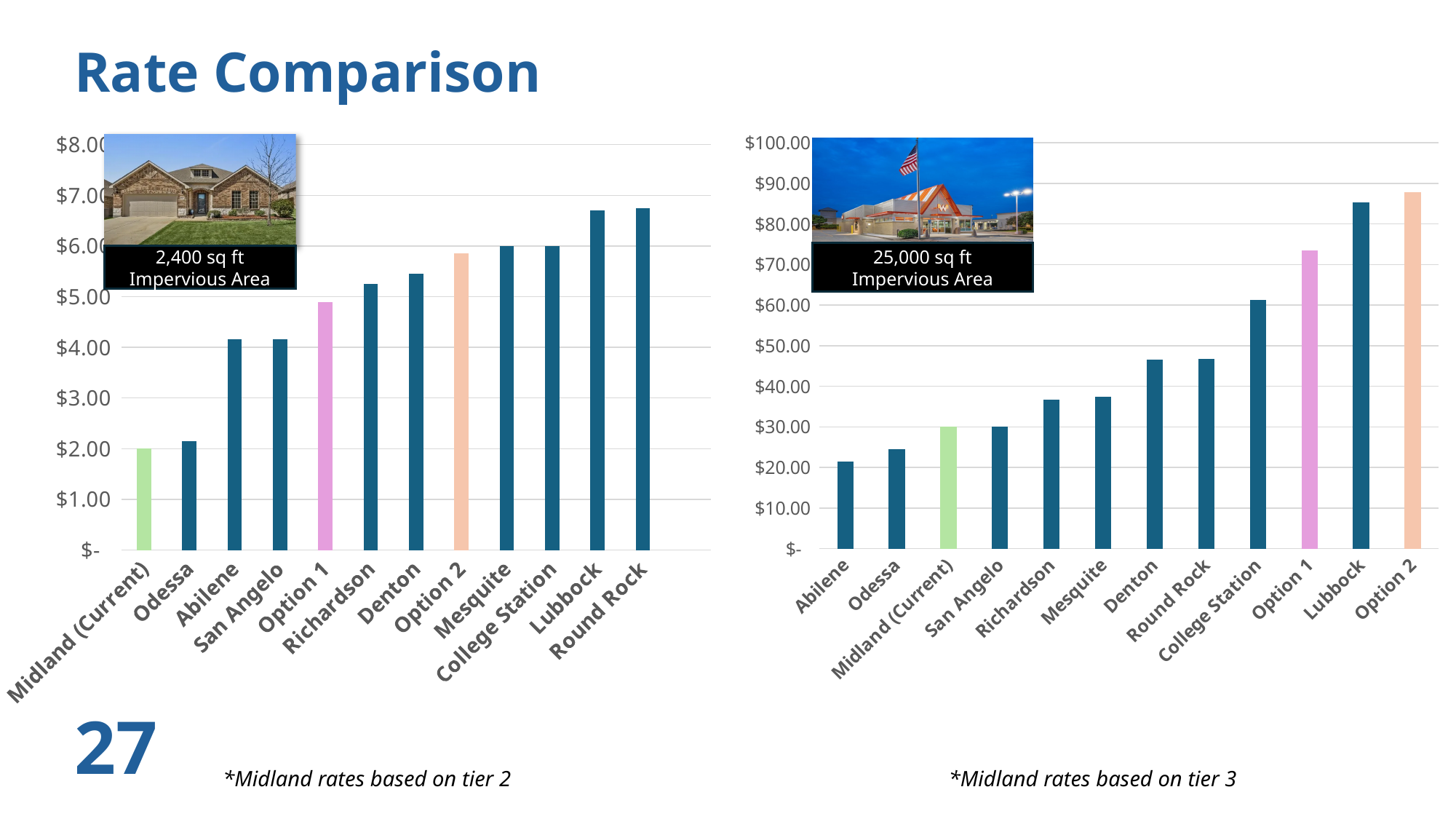
In the left chart (2,400 sq ft Impervious Area), which is larger, the value for Option 1 or the value for Abilene? Option 1 In the right chart (25,000 sq ft Impervious Area), is the value for Option 2 greater or less than $80.00? greater In the left chart (2,400 sq ft Impervious Area), is the value for Odessa greater or less than $3.00? less In the right chart (25,000 sq ft Impervious Area), is the value for College Station greater or less than $50.00? greater What kind of chart is the left chart (2,400 sq ft Impervious Area)? bar chart In the right chart (25,000 sq ft Impervious Area), which is larger, the value for Option 1 or the value for Denton? Option 1 How many categories are shown on the x axis of the right chart (25,000 sq ft Impervious Area)? 12 How many categories are shown on the x axis of the left chart (2,400 sq ft Impervious Area)? 12 In the left chart (2,400 sq ft Impervious Area), do the values generally rise or fall from left to right along the x axis? rise What is the title of the slide containing the two charts? Rate Comparison